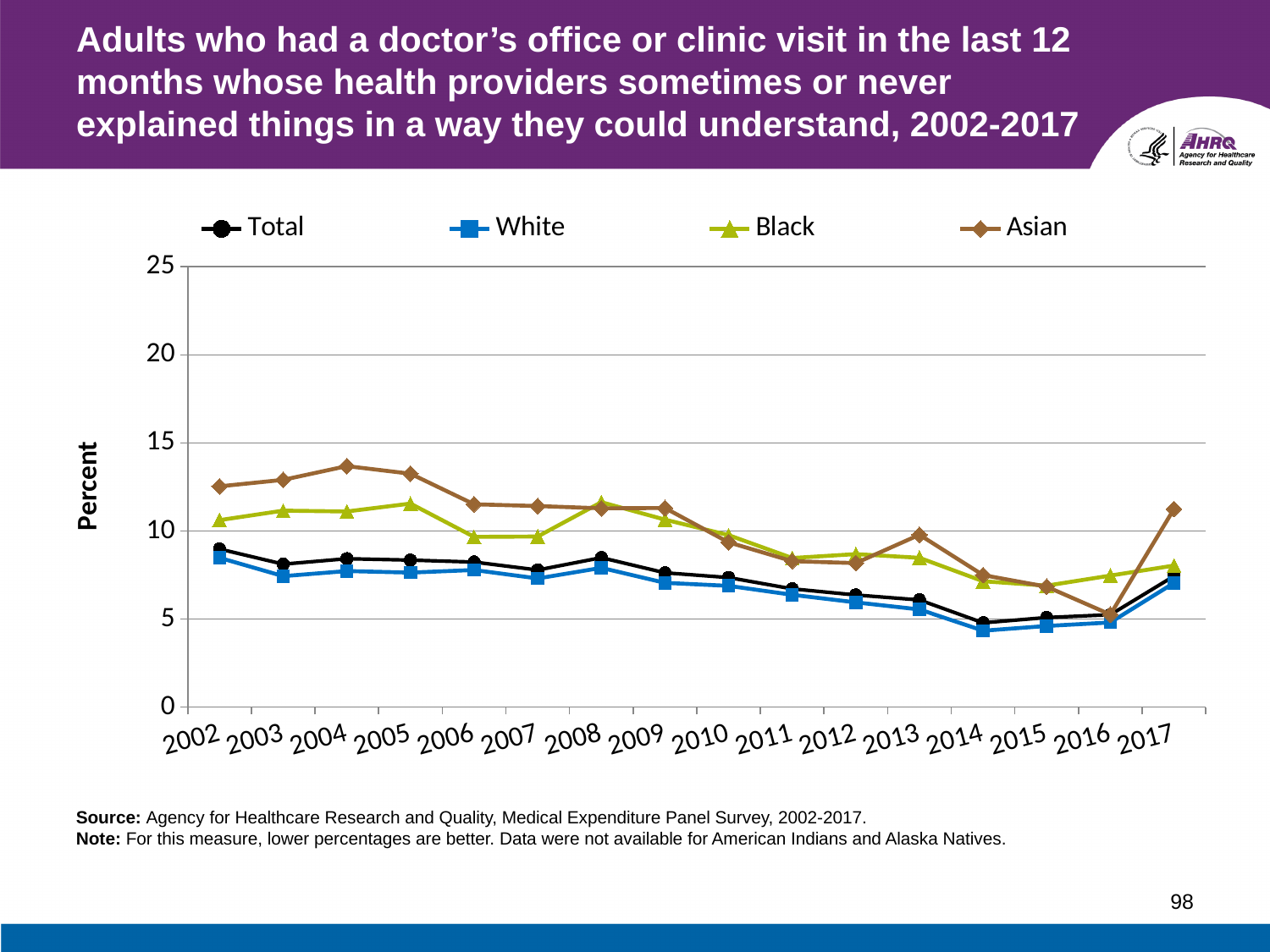
How many years are plotted along the x axis? 16 Is the value for Asian in 2004 greater or less than 10? greater What kind of chart is shown on the slide? line chart Which series has the lowest value in 2014? White What is the label on the y axis? Percent Is the value for White in 2014 greater or less than 5? less Is the value for Asian in 2017 greater or less than 10? greater How many series does the legend list? 4 In 2010, which is larger, the value for Black or the value for Total? Black Which series is shown with a brown line and diamond markers? Asian Which series has the highest value in 2004? Asian Does the Total series rise or fall from 2002 to 2014? fall